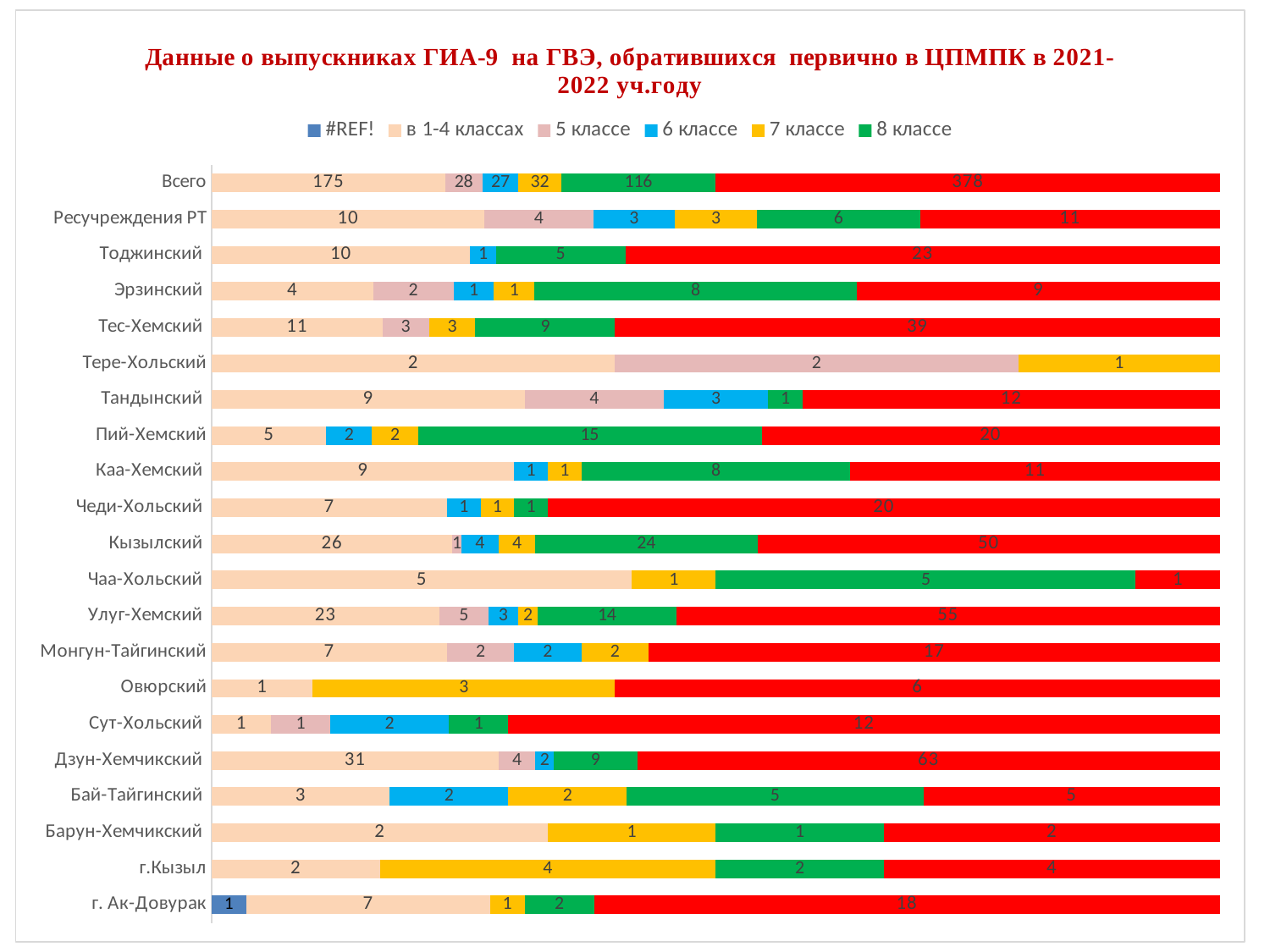
Which category has the largest value for 'в 1-4 классах'? Всего In the 'Всего' bar, what is the difference between the '8 классе' value and the '7 классе' value? 84 What is the value for '8 классе' in the 'Всего' bar? 116 What is the value for 'в 1-4 классах' for 'Дзун-Хемчикский'? 31 What is the value for 'в 1-4 классах' in the 'Всего' bar? 175 Which has the larger value for 'в 1-4 классах': 'Кызылский' or 'Улуг-Хемский'? Кызылский What value is printed on the red segment of the 'Всего' bar? 378 How many categories are plotted on the vertical axis? 21 What is the total of all segments in the 'Ресучреждения РТ' bar? 37 How many series does the legend list? 6 What kind of chart is shown on the slide? stacked bar chart What is the value for '8 классе' for 'Кызылский'? 24